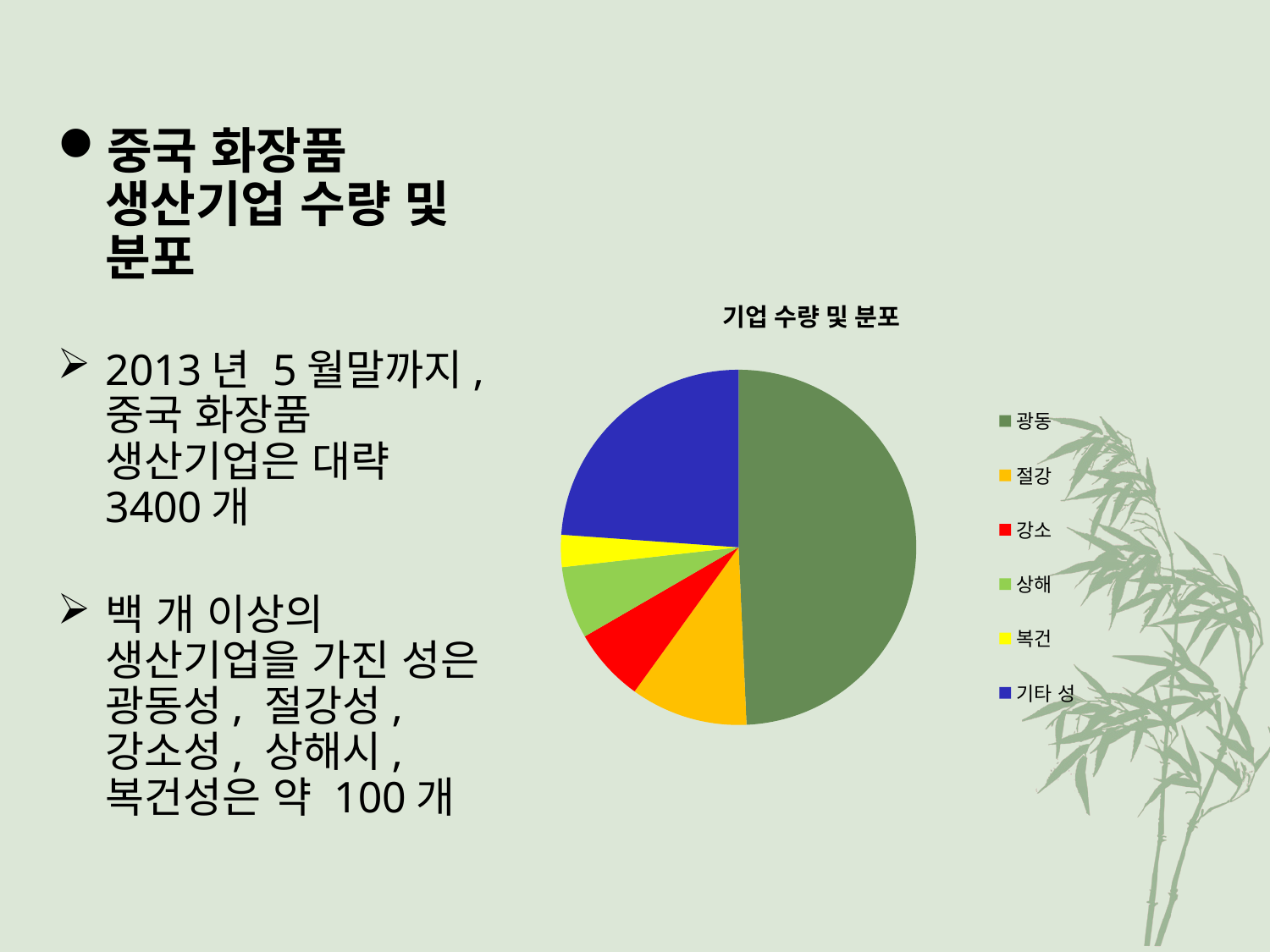
Which category has the second-largest slice of the pie? 기타 성 Which category is shown in yellow in the pie chart? 복건 How many categories (slices) does the pie chart have? 6 Which category has the largest slice of the pie? 광동 Which slice is larger, 절강 or 복건? 절강 What is the title of the chart? 기업 수량 및 분포 Which slice is larger, 기타 성 or 절강? 기타 성 What kind of chart is shown on the slide? pie chart Which slice is larger, 광동 or 기타 성? 광동 Which category has the smallest slice of the pie? 복건